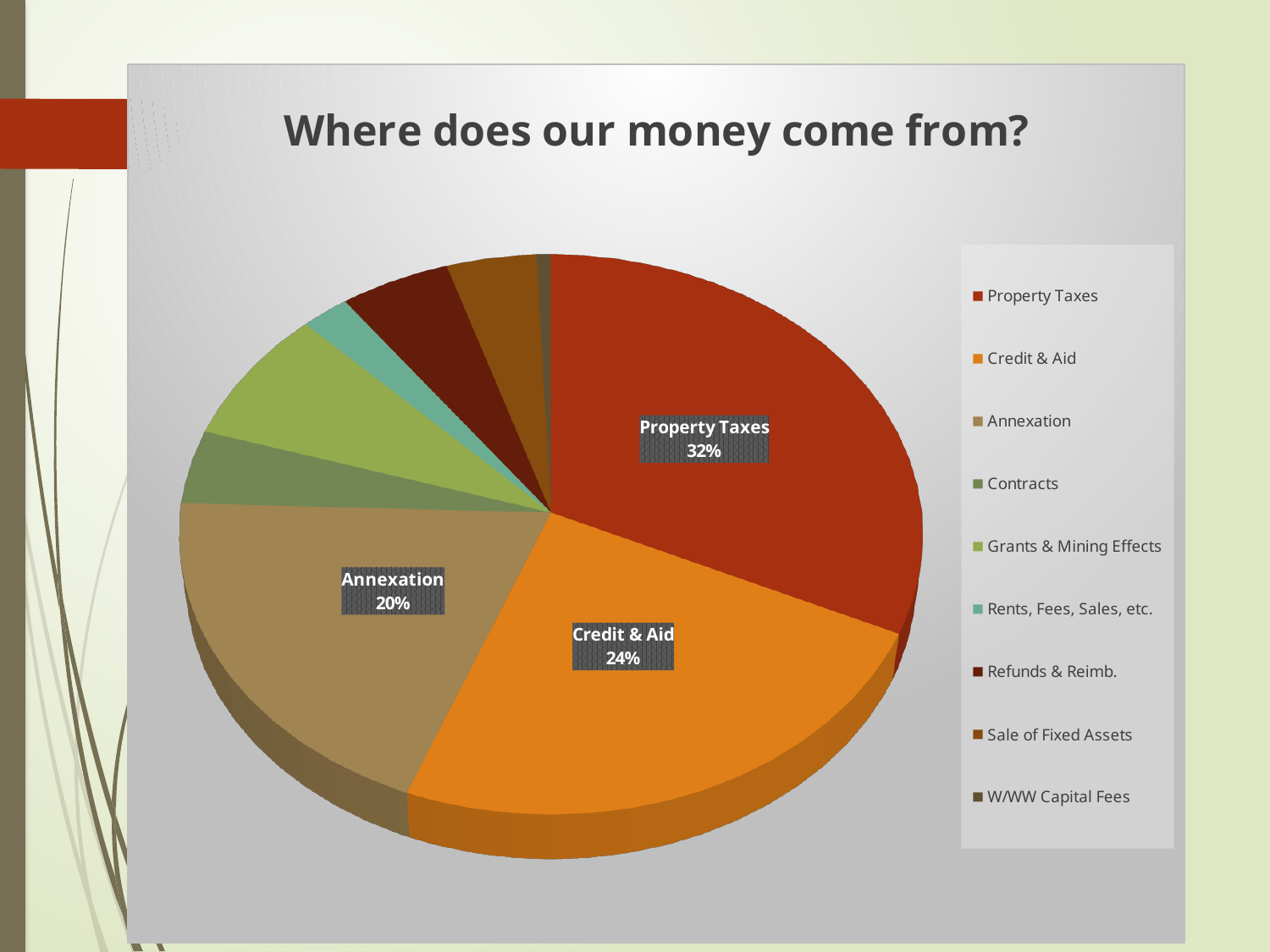
What share of the pie does Credit & Aid represent? 24% What share of the pie does Property Taxes represent? 32% What is the difference in percentage points between the Property Taxes share and the Credit & Aid share? 8 What kind of chart is shown on the slide? pie chart Which category has the largest slice of the pie? Property Taxes What is the title of the chart? Where does our money come from? Which is larger, the share for Property Taxes or the share for Credit & Aid? Property Taxes Which is larger, the share for Credit & Aid or the share for Annexation? Credit & Aid Which category has the smallest slice of the pie? W/WW Capital Fees What share of the pie does Annexation represent? 20% How many categories does the legend list? 9 Which legend entry is listed last? W/WW Capital Fees